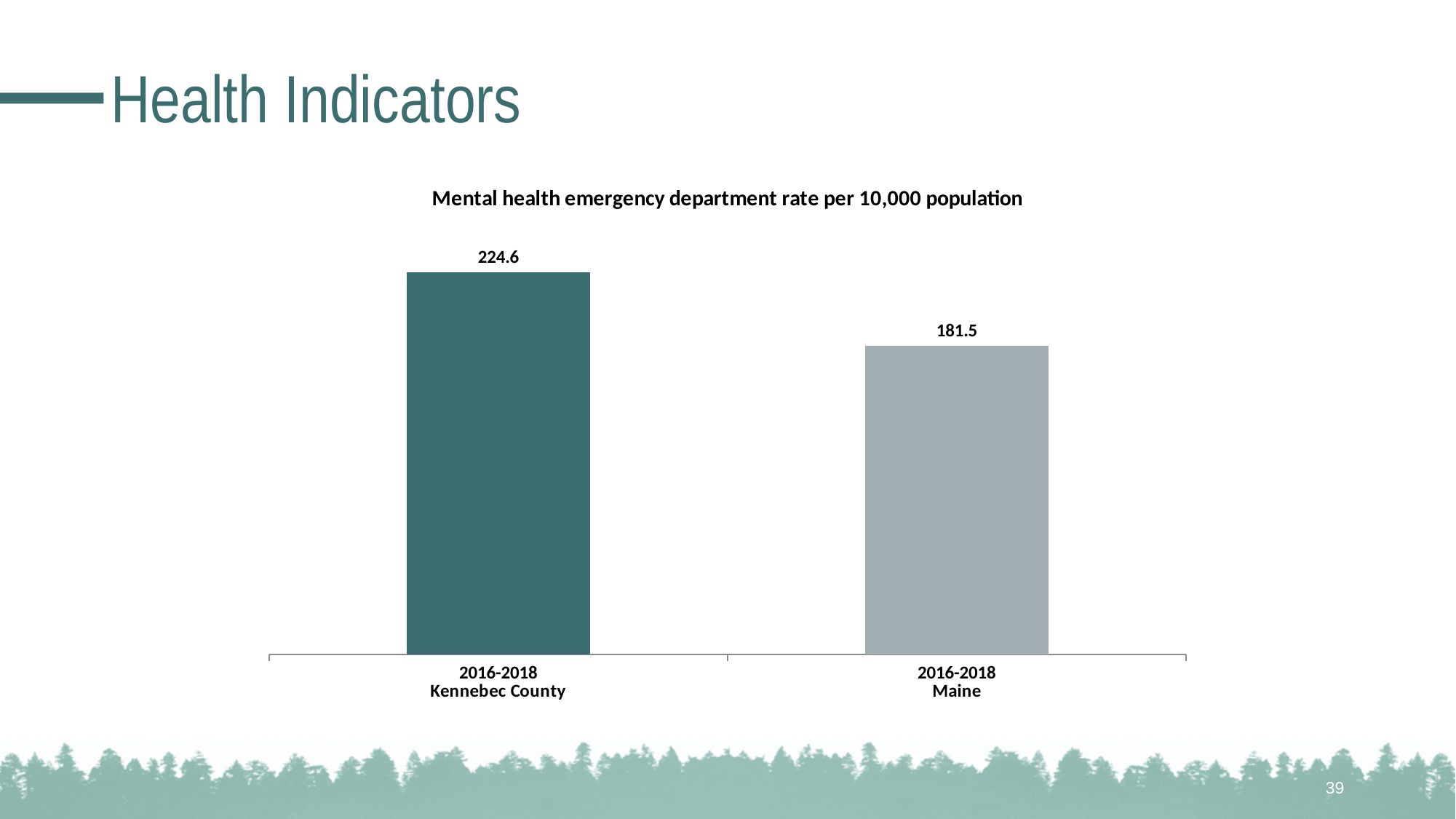
What time period do both bars in the chart cover? 2016-2018 What is the mental health emergency department rate per 10,000 population for Kennebec County (2016-2018)? 224.6 What type of chart is shown on the slide? bar chart What is the mental health emergency department rate per 10,000 population for Maine (2016-2018)? 181.5 Which category has the higher mental health emergency department rate, Kennebec County or Maine? Kennebec County Which category has the lowest mental health emergency department rate? Maine What is the title of the chart? Mental health emergency department rate per 10,000 population Is the rate for Kennebec County larger or smaller than the rate for Maine? larger What is the difference between the Kennebec County rate and the Maine rate? 43.1 How many bars are shown in the chart? 2